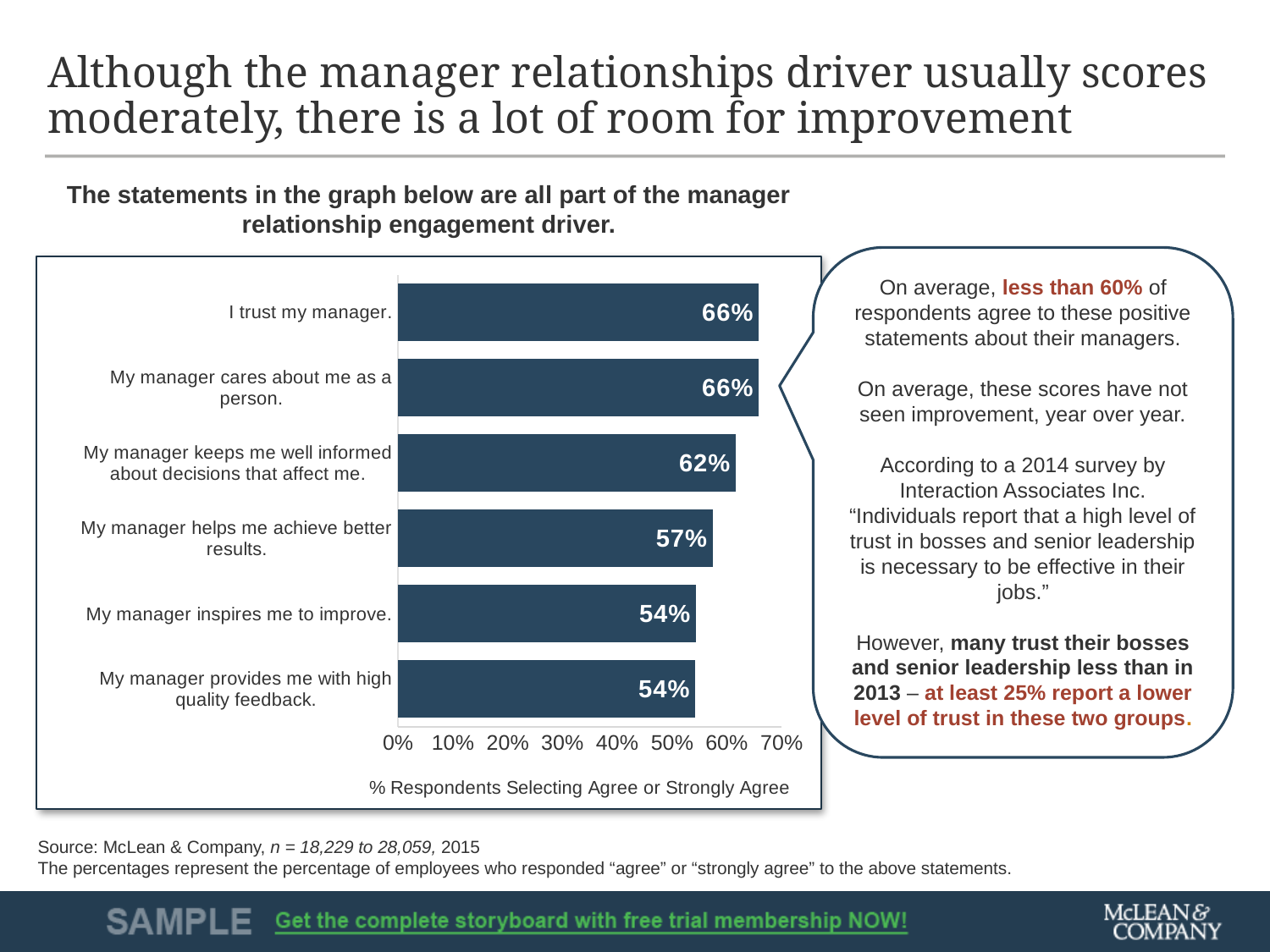
What is the difference between the value for "My manager keeps me well informed about decisions that affect me." and the value for "My manager helps me achieve better results."? 5% What kind of chart is shown on the slide? Bar chart Is the value for "My manager cares about me as a person." greater or less than 60%? greater What is the value for "My manager helps me achieve better results."? 57% What percentage of respondents agree with the statement "I trust my manager."? 66% What is the value for "My manager keeps me well informed about decisions that affect me."? 62% Which statement has the lowest value, "My manager keeps me well informed about decisions that affect me." or "My manager provides me with high quality feedback."? My manager provides me with high quality feedback. How many statements are plotted in the chart? 6 What is the label on the horizontal axis of the chart? % Respondents Selecting Agree or Strongly Agree What is the value for "My manager inspires me to improve."? 54% Is the value for "My manager provides me with high quality feedback." greater or less than 60%? less What is the difference between the value for "I trust my manager." and the value for "My manager inspires me to improve."? 12%